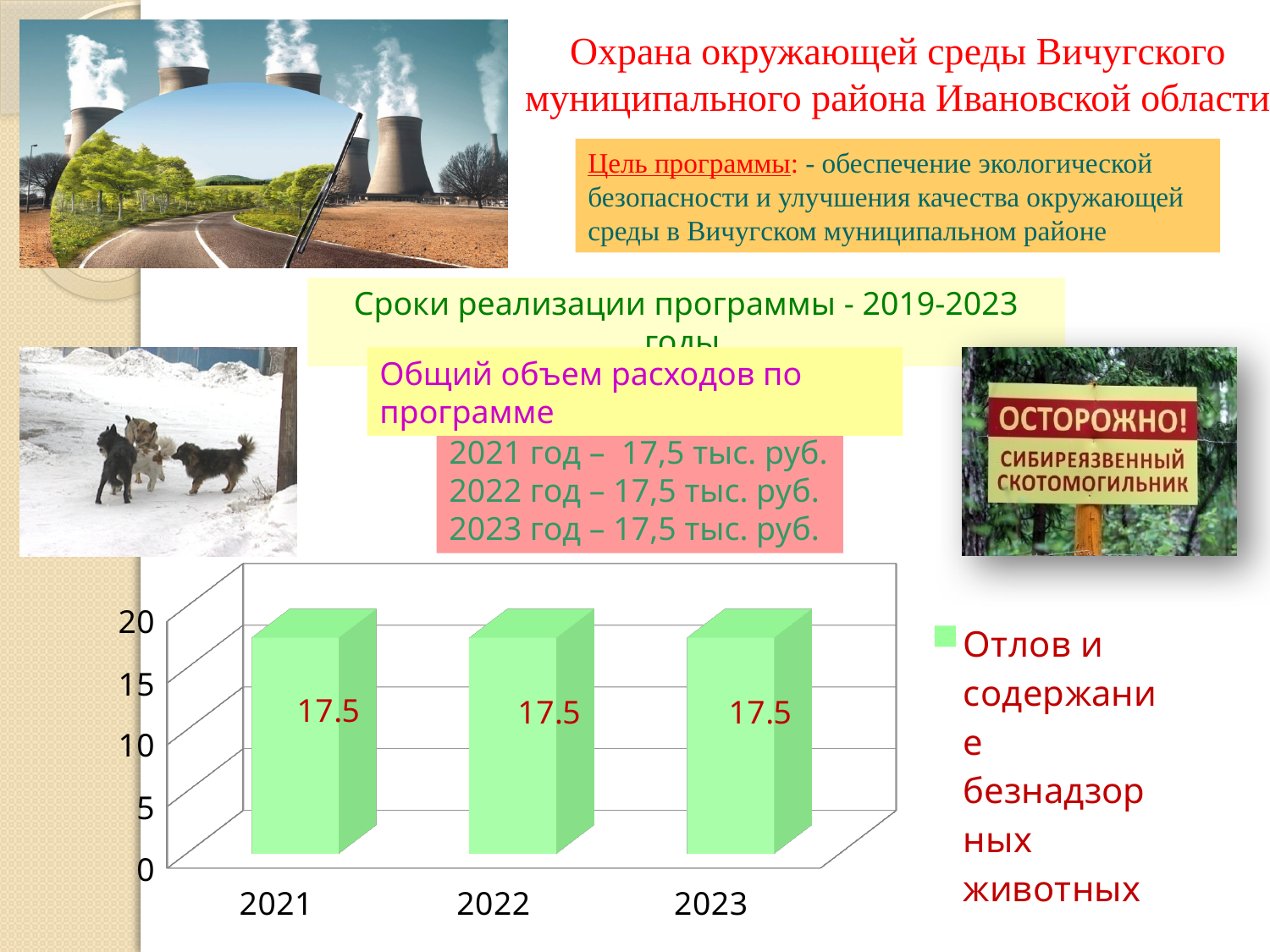
What is the value for 2021 in the bar chart? 17.5 Is the value for 2022 greater or less than 15? greater How many series does the chart legend list? 1 How many categories are shown on the x axis of the bar chart? 3 What series name is shown in the chart legend? Отлов и содержание безнадзорных животных Do the values rise, fall or stay the same from 2021 to 2023? stay the same What kind of chart is shown on the slide? bar chart What is the difference between the values for 2021 and 2023 in the bar chart? 0 What colour are the bars in the chart? green What is the value for 2022 in the bar chart? 17.5 What is the value for 2023 in the bar chart? 17.5 Is the value for 2023 greater or less than 20? less